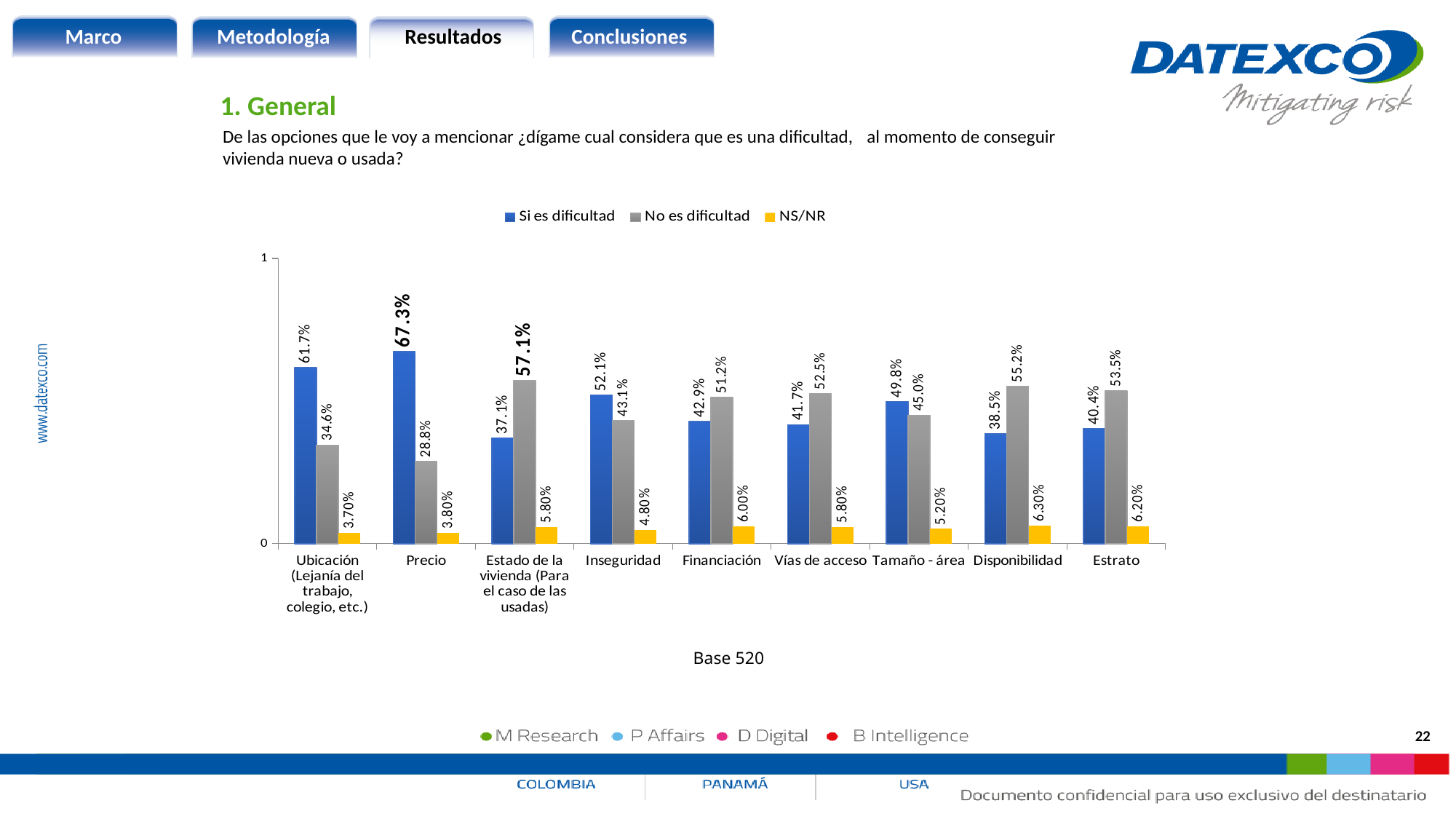
What is the difference between the "Si es dificultad" and "No es dificultad" values for Ubicación (Lejanía del trabajo, colegio, etc.)? 27.1% What is the NS/NR value for Disponibilidad? 6.30% What is the value of "Si es dificultad" for Precio? 67.3% What is the value of "Si es dificultad" for Inseguridad? 52.1% How many categories are shown on the x axis? 9 For Financiación, which is larger: "Si es dificultad" or "No es dificultad"? No es dificultad How many series does the legend list? 3 What kind of chart is shown on the slide? Bar chart Which category has the highest "Si es dificultad" value? Precio Which category has the lowest NS/NR value? Ubicación (Lejanía del trabajo, colegio, etc.) What is the value of "No es dificultad" for Estado de la vivienda (Para el caso de las usadas)? 57.1% Which category has the lowest "No es dificultad" value? Precio